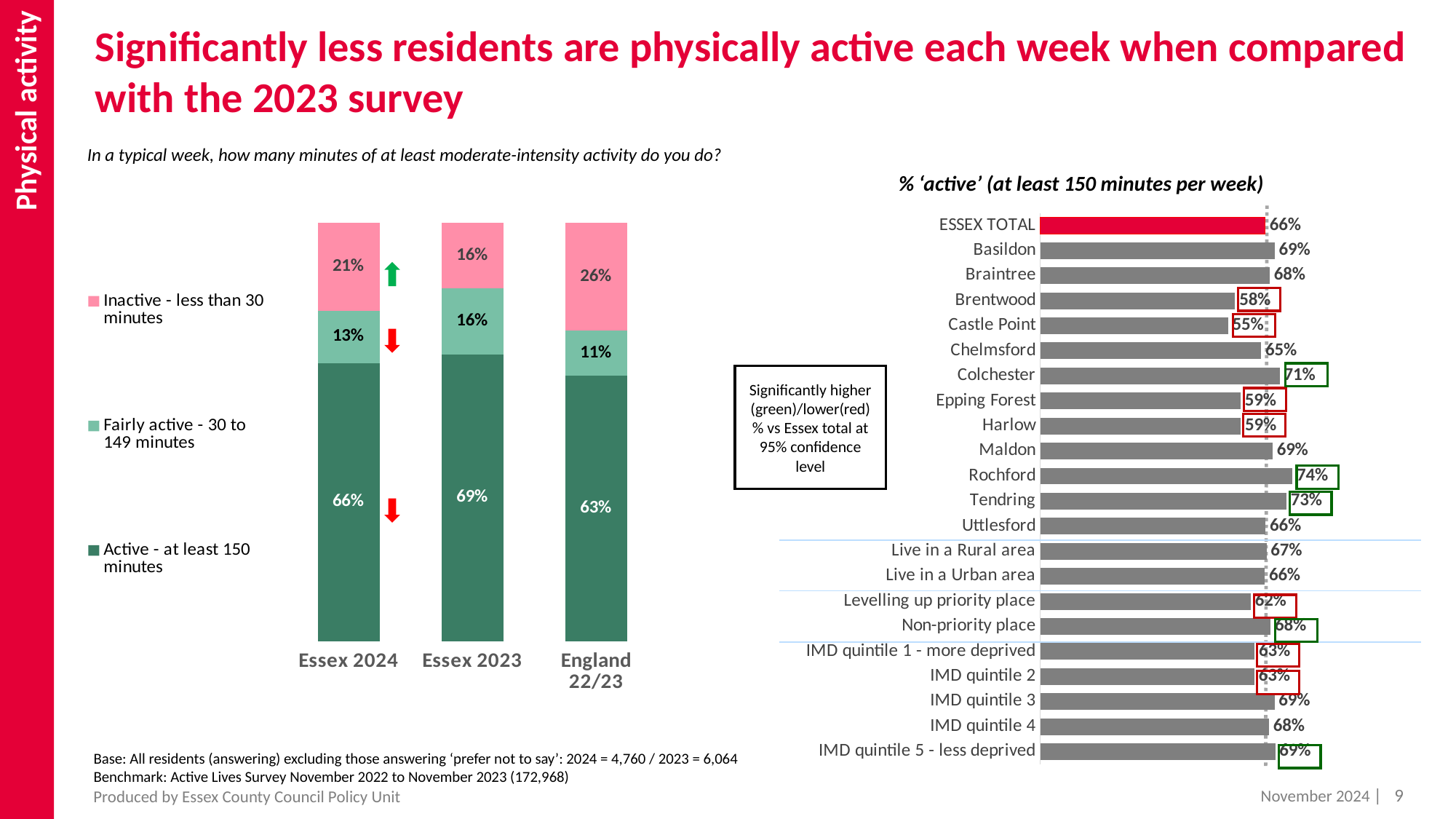
In the stacked bar chart on the left, which bar has the highest 'Inactive - less than 30 minutes' share? England 22/23 In the '% active (at least 150 minutes per week)' chart, what is the value for Castle Point? 55% In the stacked bar chart on the left, what is the difference between the 'Active' share for Essex 2023 and Essex 2024? 3% In the stacked bar chart on the left, what is the 'Fairly active - 30 to 149 minutes' value for England 22/23? 11% In the '% active (at least 150 minutes per week)' chart, which area has the highest value? Rochford What type of chart is the '% active (at least 150 minutes per week)' chart? Bar chart In the stacked bar chart on the left, how many series does the legend list? 3 In the '% active (at least 150 minutes per week)' chart, which area has the lowest value? Castle Point In the '% active (at least 150 minutes per week)' chart, which is larger: Colchester or Chelmsford? Colchester In the stacked bar chart on the left, what percentage of Essex 2024 residents are 'Active - at least 150 minutes'? 66% In the stacked bar chart on the left, what percentage of Essex 2023 residents are 'Inactive - less than 30 minutes'? 16% In the '% active (at least 150 minutes per week)' chart, what is the value for ESSEX TOTAL? 66%